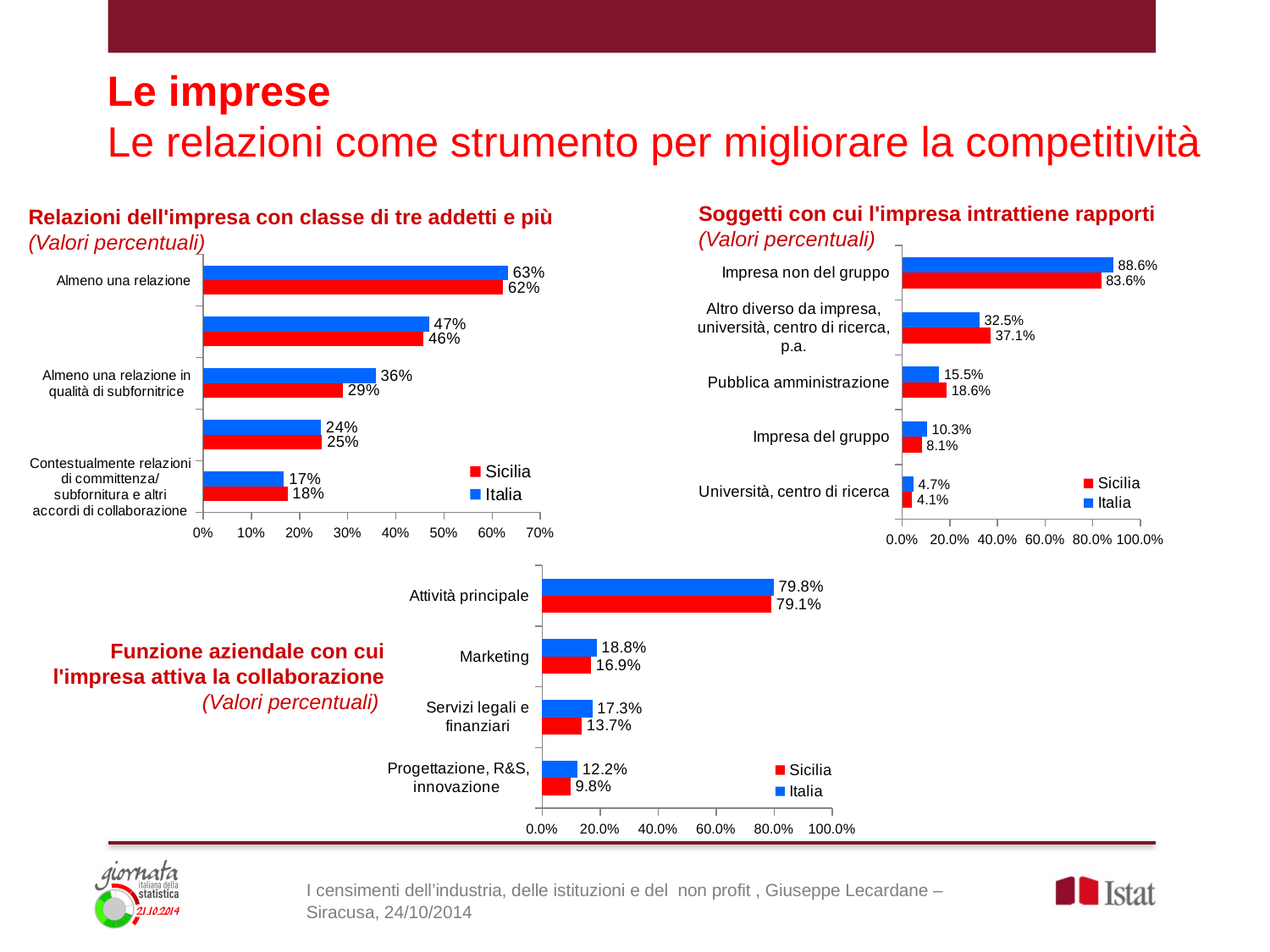
In the chart 'Funzione aziendale con cui l'impresa attiva la collaborazione', what is the value for Sicilia for 'Progettazione, R&S, innovazione'? 9.8% In the chart 'Funzione aziendale con cui l'impresa attiva la collaborazione', what is the value for Italia for 'Marketing'? 18.8% In the chart 'Soggetti con cui l'impresa intrattiene rapporti', how many categories are shown? 5 In the chart 'Relazioni dell'impresa con classe di tre addetti e più', what is the difference between Italia and Sicilia for 'Almeno una relazione'? 1% In the chart 'Soggetti con cui l'impresa intrattiene rapporti', which category has the lowest value for Sicilia? Università, centro di ricerca In the chart 'Soggetti con cui l'impresa intrattiene rapporti', what is the value for Italia for 'Pubblica amministrazione'? 15.5% In the chart 'Relazioni dell'impresa con classe di tre addetti e più', what is the value for Italia for 'Almeno una relazione'? 63% What type of chart is 'Funzione aziendale con cui l'impresa attiva la collaborazione'? bar chart In the chart 'Funzione aziendale con cui l'impresa attiva la collaborazione', is the value for Sicilia for 'Servizi legali e finanziari' larger or smaller than the value for Italia? smaller In the chart 'Soggetti con cui l'impresa intrattiene rapporti', what is the value for Sicilia for 'Impresa non del gruppo'? 83.6% In the chart 'Soggetti con cui l'impresa intrattiene rapporti', what is the difference between Sicilia and Italia for 'Altro diverso da impresa, università, centro di ricerca, p.a.'? 4.6% In the chart 'Funzione aziendale con cui l'impresa attiva la collaborazione', which category has the highest value for Italia? Attività principale